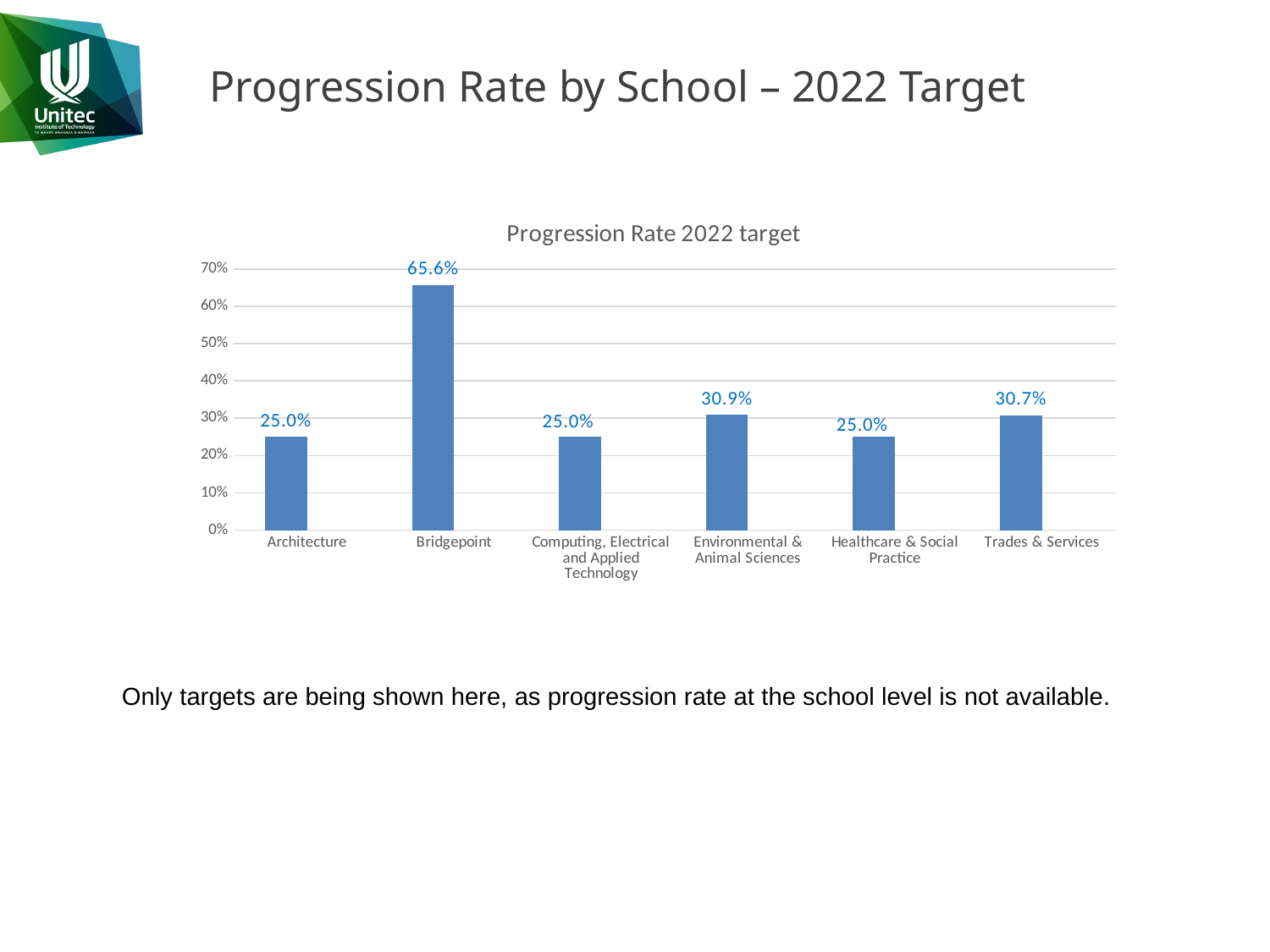
What is the difference between the Environmental & Animal Sciences target and the Trades & Services target? 0.2% What is the title of the chart? Progression Rate 2022 target What kind of chart is shown on the slide? Bar chart What is the progression rate 2022 target for Bridgepoint? 65.6% What is the progression rate 2022 target for Environmental & Animal Sciences? 30.9% Is the value for Bridgepoint greater or less than 60%? greater What is the difference between the Bridgepoint target and the Architecture target? 40.6% How many schools are shown on the chart? 6 Which school has the highest progression rate 2022 target? Bridgepoint What is the progression rate 2022 target for Trades & Services? 30.7% Which is larger, the target for Bridgepoint or the target for Healthcare & Social Practice? Bridgepoint What is the progression rate 2022 target for Architecture? 25.0%